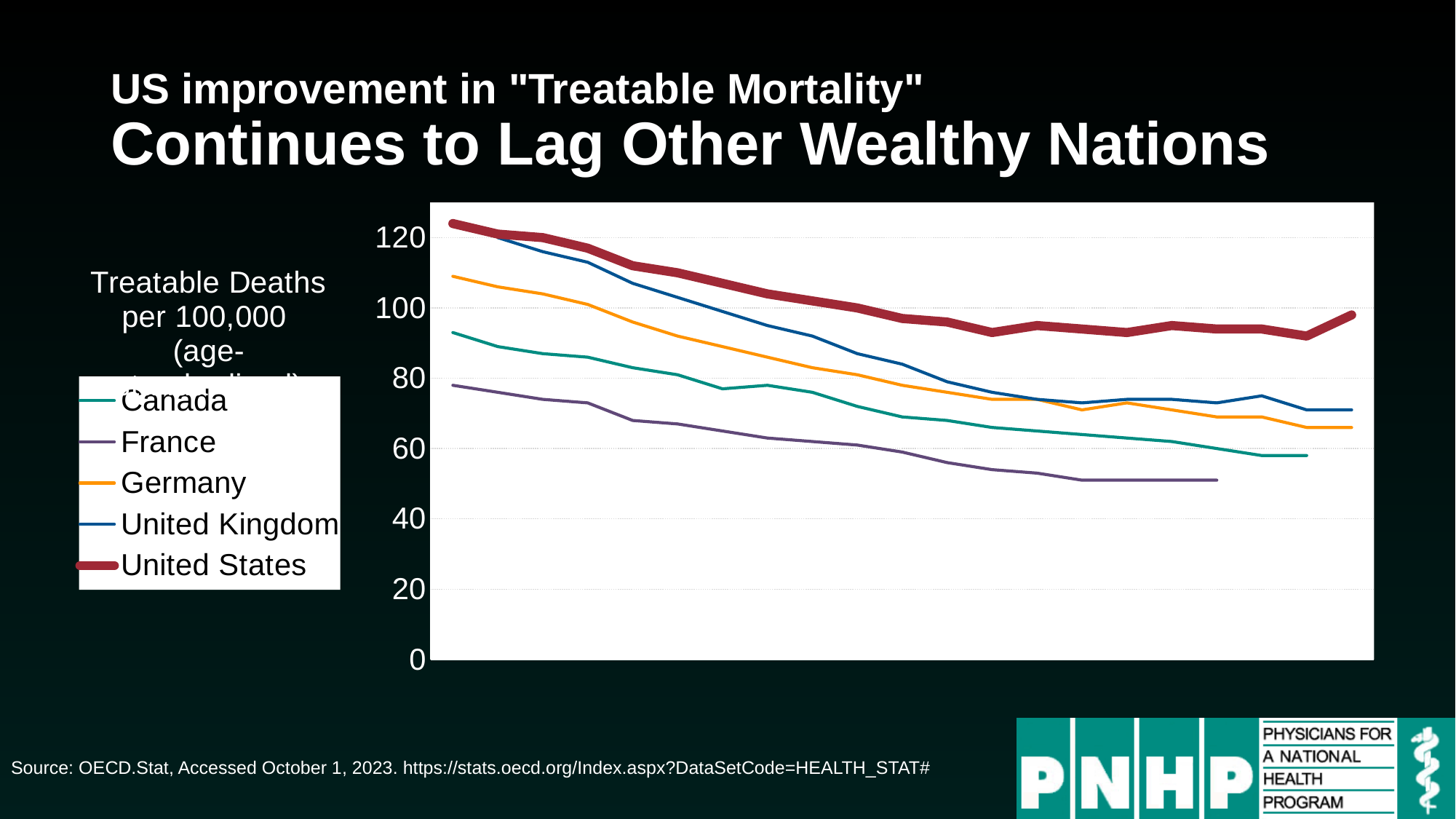
Which country's line is the lowest across the chart? France At the right end of the chart, which is higher, the United States or Canada? United States What kind of chart is shown on the slide? line chart Does the United States line generally rise or fall from left to right? fall At the right end of the chart, is the value for France greater or less than 60? less How many series does the legend list? 5 Which country's line is the highest across the chart? United States At the right end of the chart, is the value for the United Kingdom greater or less than 60? greater Does the France line rise or fall from left to right? fall At the left end of the chart, which is higher, Germany or France? Germany What does the y axis of the chart measure, according to the label on the slide? Treatable Deaths per 100,000 (age-standardized) At the left end of the chart, is the value for Canada greater or less than 100? less